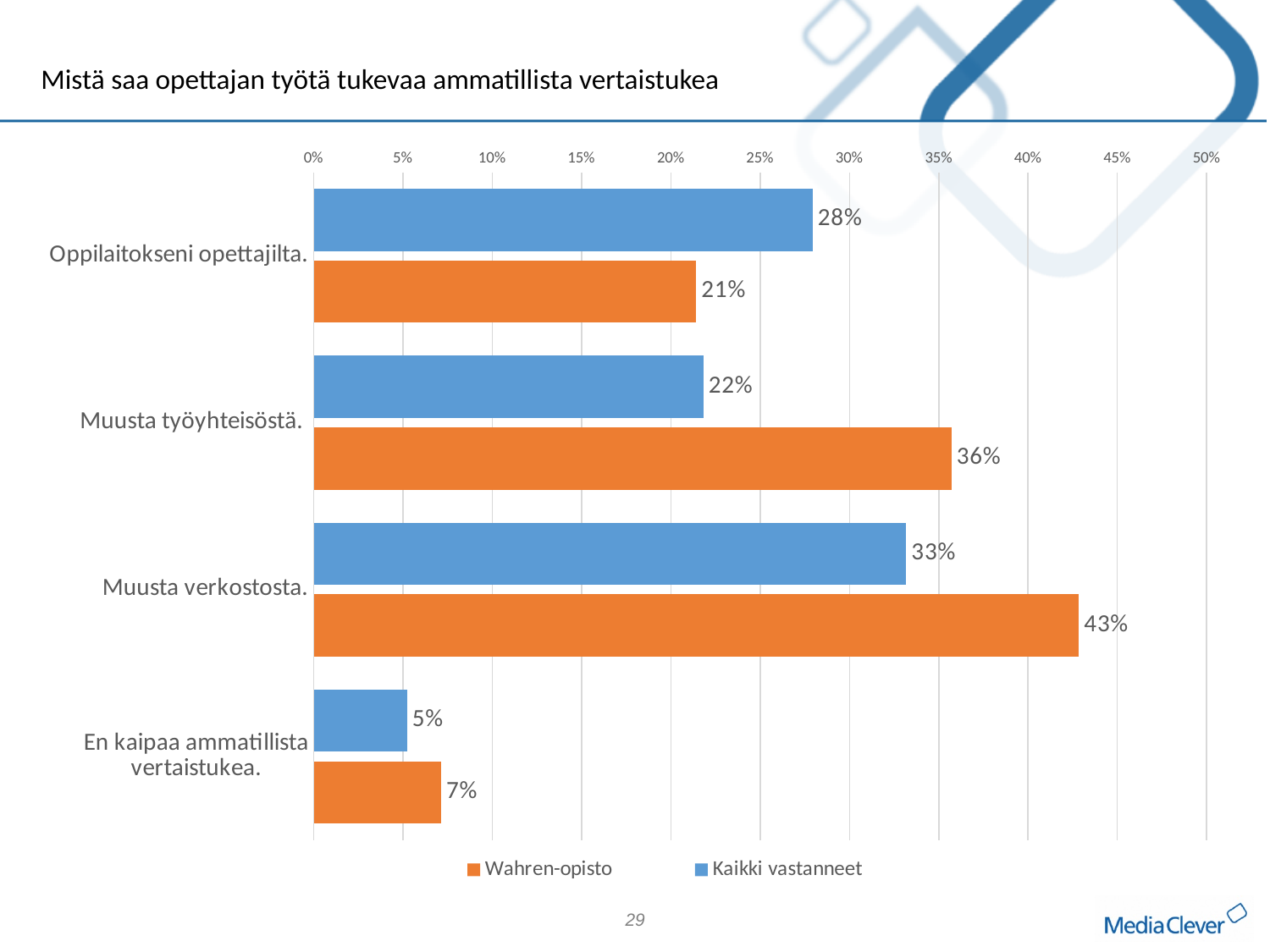
What is the value for Wahren-opisto in the category "Muusta verkostosta."? 43% What is the value for Wahren-opisto in the category "Muusta työyhteisöstä."? 36% How many categories are shown on the chart? 4 What kind of chart is shown on the slide? Bar chart Which colour represents the Wahren-opisto series? Orange Which category has the lowest value for Wahren-opisto? En kaipaa ammatillista vertaistukea. How many series does the legend list? 2 What is the value for Kaikki vastanneet in the category "Oppilaitokseni opettajilta."? 28% Which category has the highest value for Kaikki vastanneet? Muusta verkostosta. What is the difference between the Wahren-opisto and Kaikki vastanneet values for "Muusta työyhteisöstä."? 14% Is the value for Wahren-opisto in "Muusta verkostosta." greater or less than 40%? greater For "Oppilaitokseni opettajilta.", which series has the larger value, Wahren-opisto or Kaikki vastanneet? Kaikki vastanneet